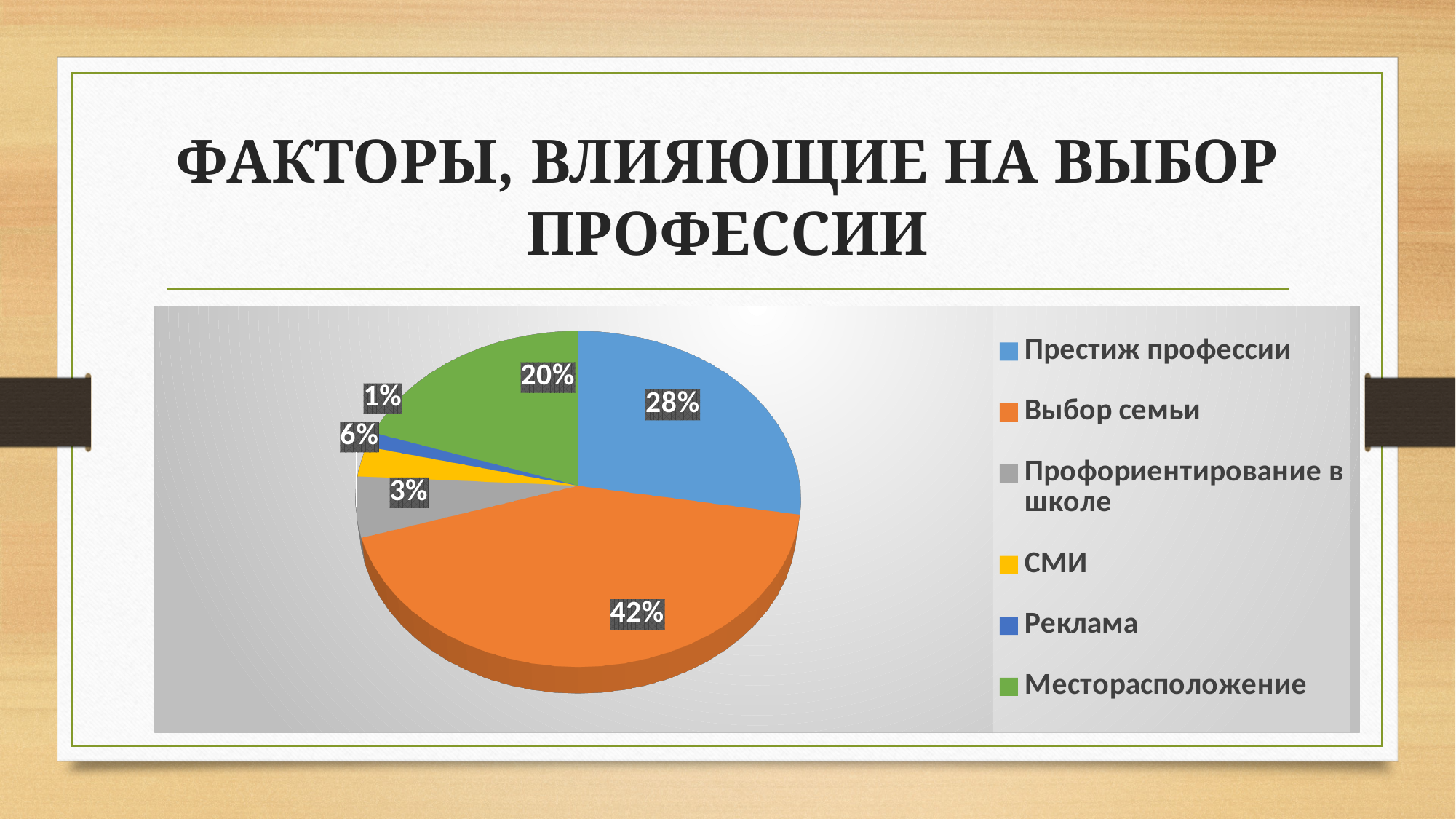
What share of the pie does "Престиж профессии" have? 28% What share of the pie does "Месторасположение" have? 20% Which is larger: the share for "Месторасположение" or the share for "Профориентирование в школе"? Месторасположение Which factor has the largest slice of the pie? Выбор семьи Which factor has the smallest slice of the pie? Реклама What share of the pie does "Реклама" have? 1% What is the difference between the shares of "Выбор семьи" and "Престиж профессии"? 14% What share of the pie does "Выбор семьи" have? 42% What colour is the slice for "Месторасположение"? Green How many categories does the pie chart have? 6 What share of the pie does "СМИ" have? 3% What kind of chart is shown on the slide? Pie chart